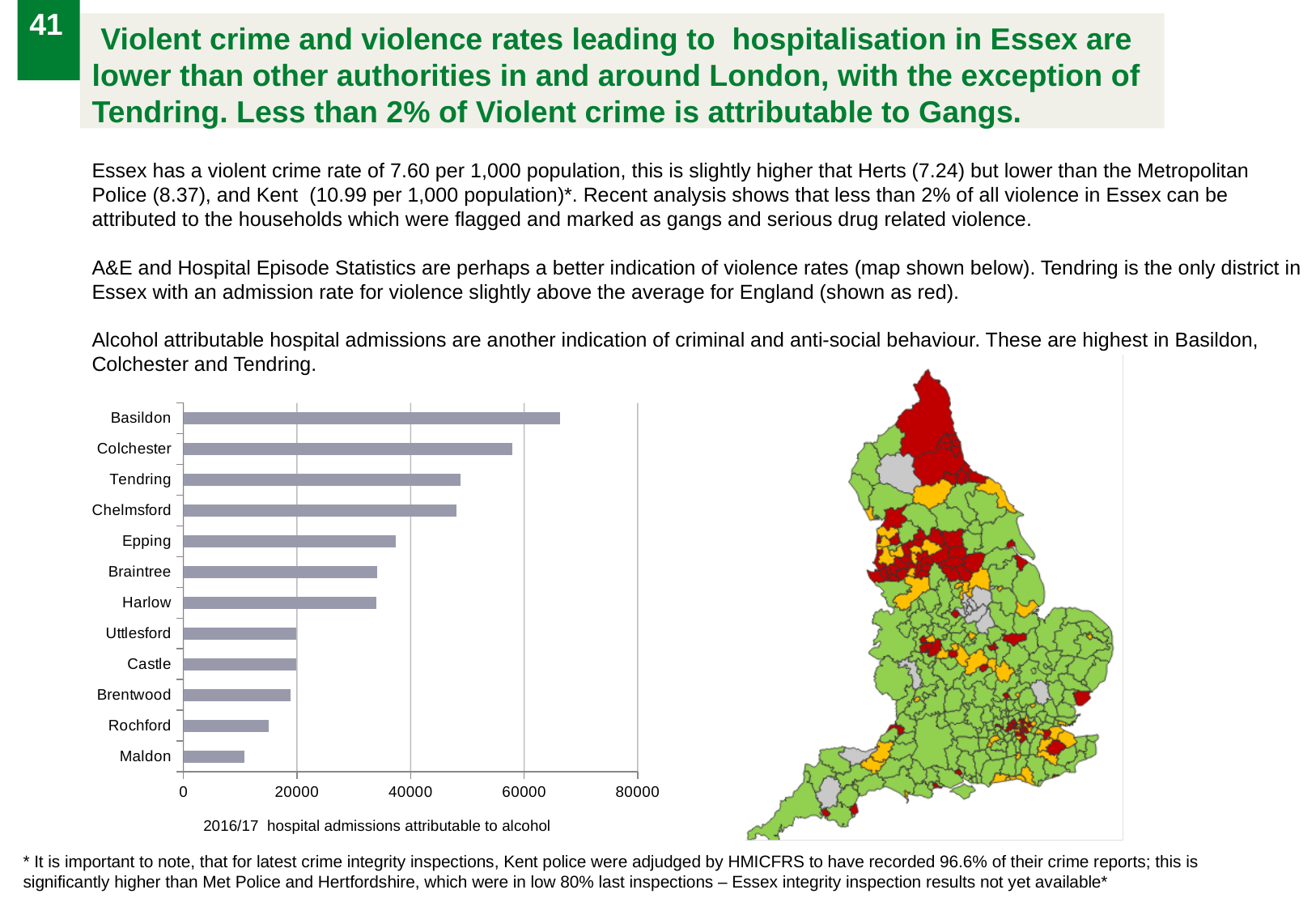
What is the highest value shown on the horizontal axis of the bar chart? 80000 What is the caption shown beneath the bar chart? 2016/17 hospital admissions attributable to alcohol Which district has the lowest number of 2016/17 hospital admissions attributable to alcohol? Maldon Is the value for Maldon greater or less than 20000? less Is the value for Rochford greater or less than 20000? less Is the value for Tendring greater or less than 40000? greater Which has more hospital admissions attributable to alcohol, Rochford or Maldon? Rochford What kind of chart is shown on the slide? bar chart How many districts are shown in the bar chart? 12 Which has more hospital admissions attributable to alcohol, Basildon or Colchester? Basildon Which district has the highest number of 2016/17 hospital admissions attributable to alcohol? Basildon